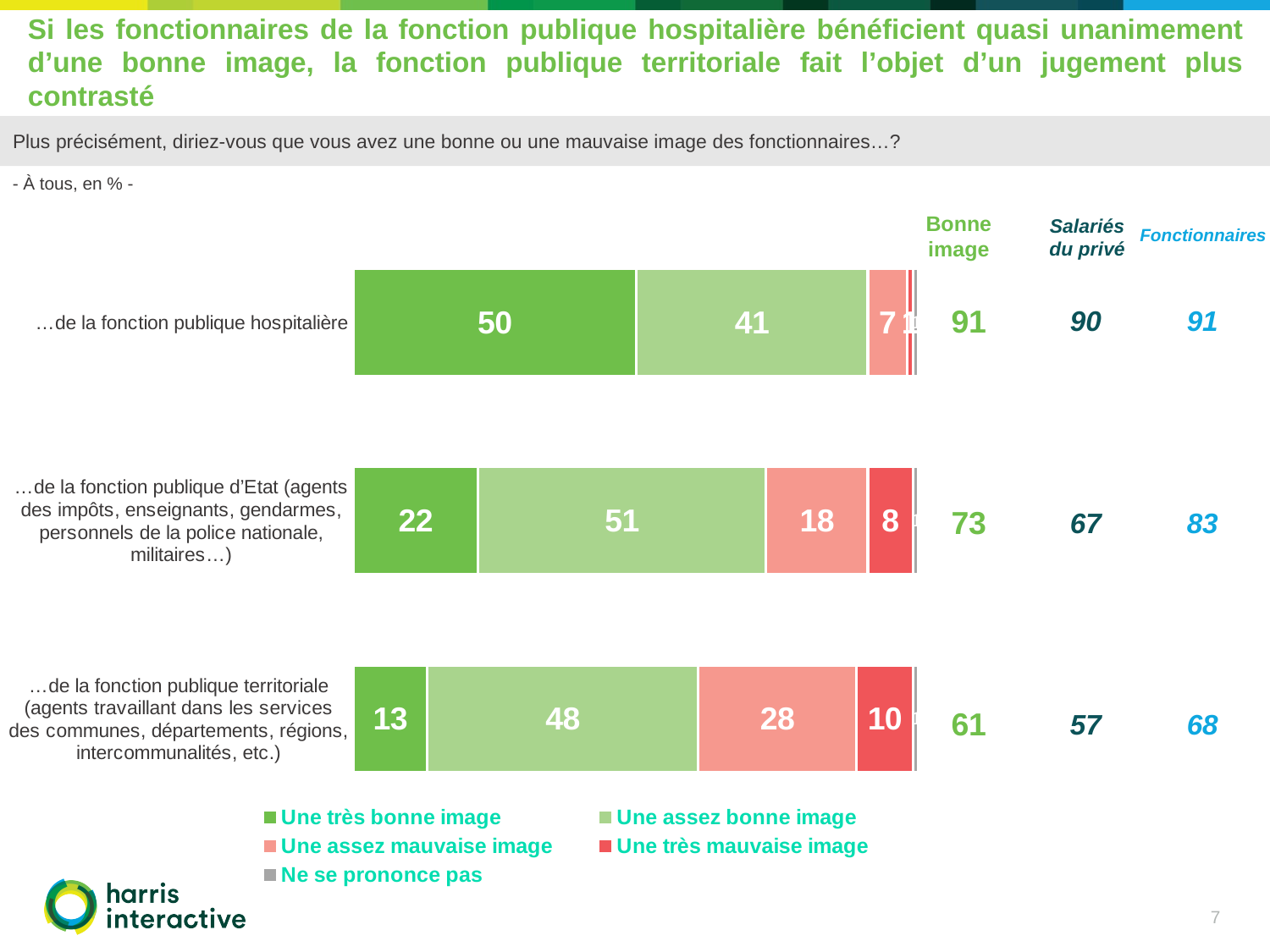
What is the value for 'Une assez bonne image' for the fonction publique d'Etat? 51 What is the difference between the 'Une assez mauvaise image' values for the fonction publique territoriale and the fonction publique d'Etat? 10 Which category has the lowest value for 'Une très bonne image'? …de la fonction publique territoriale What is the value for 'Une très bonne image' for the fonction publique hospitalière? 50 How many series does the legend list? 5 What is the value for 'Une assez mauvaise image' for the fonction publique territoriale? 28 What is the value for 'Une très mauvaise image' for the fonction publique d'Etat? 8 Which category has the highest value for 'Une très bonne image'? …de la fonction publique hospitalière How many categories (types of fonction publique) are plotted in the chart? 3 What type of chart is shown on the slide? stacked bar chart What 'Bonne image' total is shown for the fonction publique territoriale? 61 Which is larger: the 'Une très mauvaise image' value for the fonction publique territoriale or for the fonction publique d'Etat? fonction publique territoriale